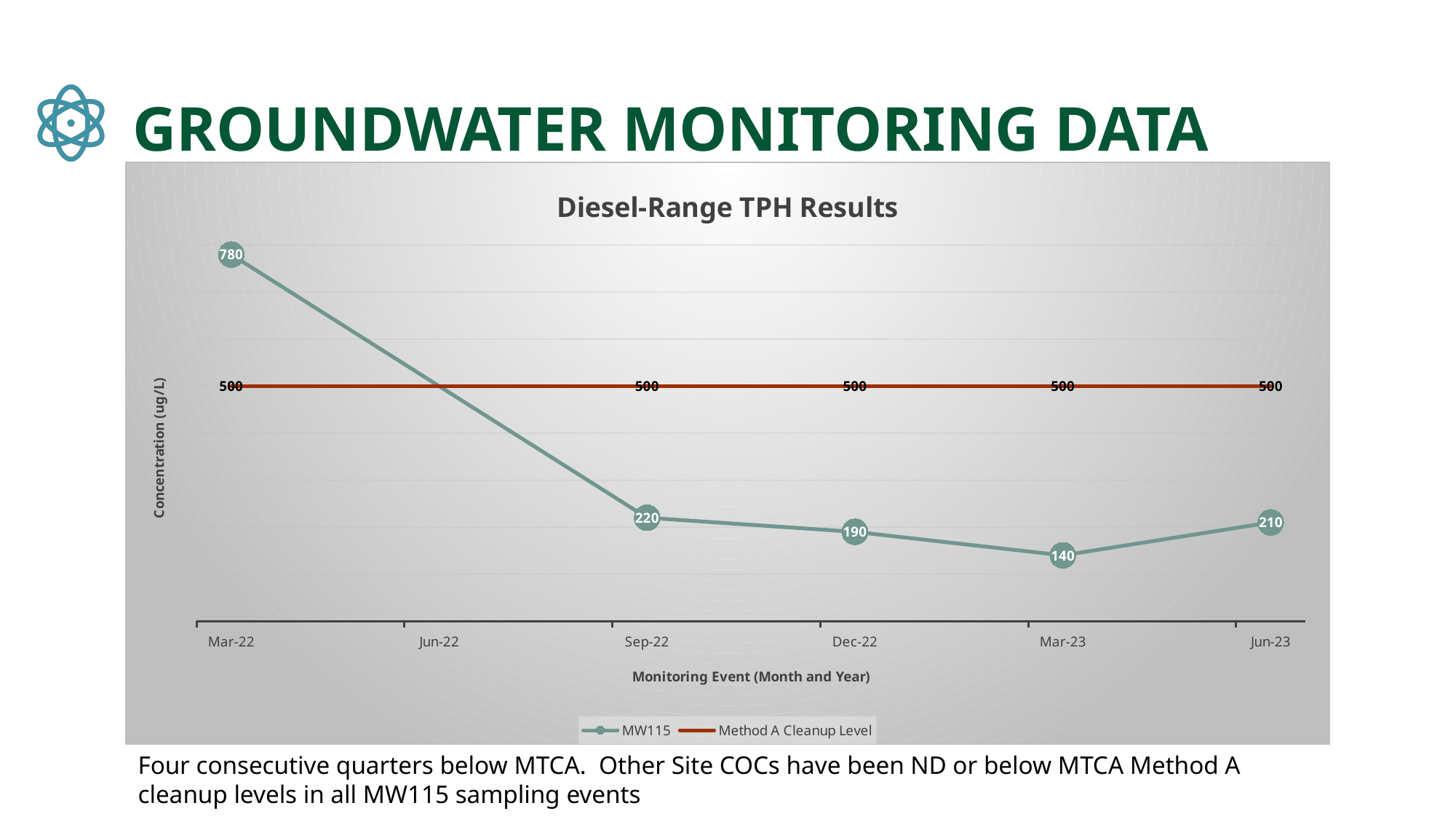
What is the MW115 value for Mar-22? 780 What is the difference between the MW115 values for Mar-22 and Sep-22? 560 At which monitoring event is the MW115 value highest? Mar-22 What is the MW115 value for Mar-23? 140 What is the MW115 value for Sep-22? 220 At which monitoring event is the MW115 value lowest? Mar-23 What is the Method A Cleanup Level value shown at Sep-22? 500 Which is larger, the MW115 value for Jun-23 or for Dec-22? Jun-23 What is the MW115 value for Dec-22? 190 What kind of chart is shown on the slide? Line chart How many series does the legend list? 2 What is the MW115 value for Jun-23? 210